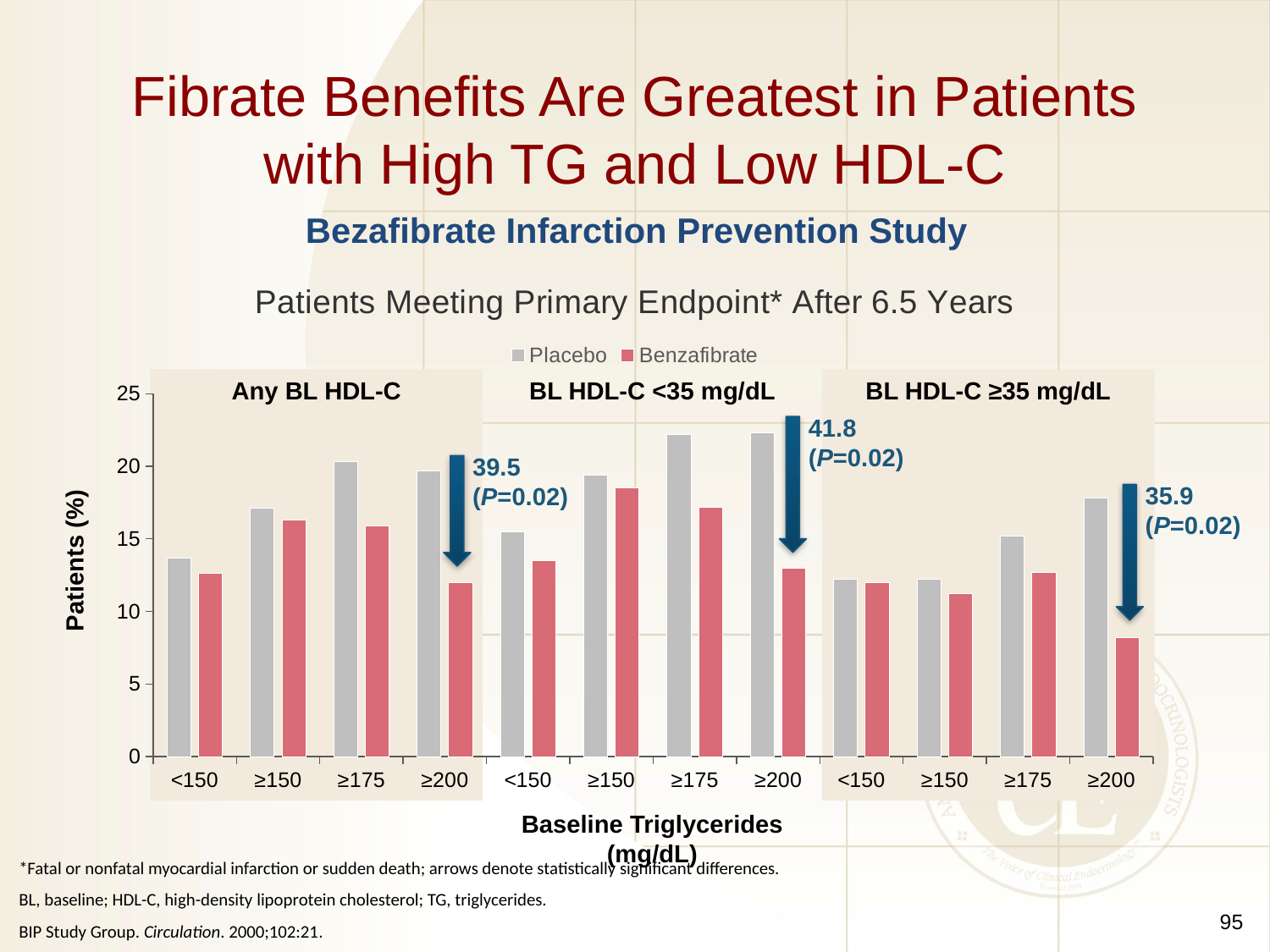
In the BL HDL-C ≥35 mg/dL panel at ≥200 mg/dL, which series has the larger value, Placebo or Benzafibrate? Placebo How many series does the legend list? 2 Is the Benzafibrate value for ≥200 mg/dL in the Any BL HDL-C panel greater or less than 15? less What P value is shown next to the 39.5 annotation in the Any BL HDL-C panel? P=0.02 Is the Placebo value for ≥200 mg/dL in the BL HDL-C <35 mg/dL panel greater or less than 20? greater How many baseline triglyceride categories are shown along the x axis? 12 Which bar is the lowest on the whole chart? Benzafibrate, ≥200 mg/dL, BL HDL-C ≥35 mg/dL Is the Benzafibrate value for ≥200 mg/dL in the BL HDL-C ≥35 mg/dL panel greater or less than 10? less What percentage reduction is annotated above the ≥200 mg/dL group in the BL HDL-C <35 mg/dL panel? 41.8 What percentage reduction is annotated above the ≥200 mg/dL group in the BL HDL-C ≥35 mg/dL panel? 35.9 What kind of chart is shown on the slide? bar chart What colour represents the Benzafibrate series in the legend? red